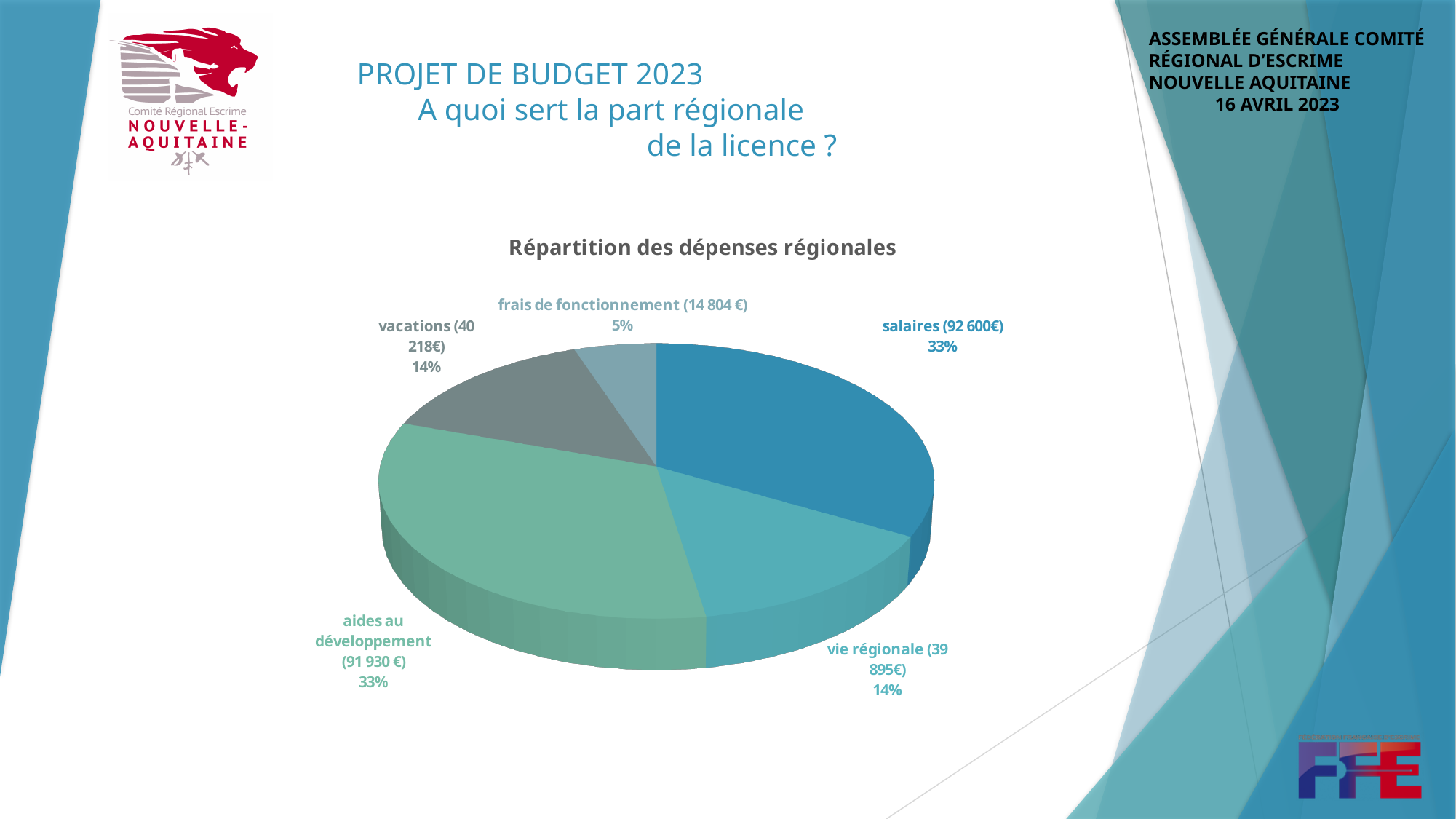
Which amount is larger: 'salaires' or 'aides au développement'? salaires What kind of chart is shown on the slide? pie chart What is the difference in euros between 'vacations' and 'vie régionale'? 323€ How many slices does the pie chart have? 5 What amount is shown for 'frais de fonctionnement'? 14 804 € What percentage share does 'aides au développement' represent? 33% Which category has the smallest share of the pie? frais de fonctionnement What percentage share does 'vacations' represent? 14% What is the title of the chart? Répartition des dépenses régionales What amount is shown for 'vie régionale'? 39 895€ What is the difference in euros between 'salaires' and 'aides au développement'? 670€ What percentage share does the 'salaires' slice represent? 33%